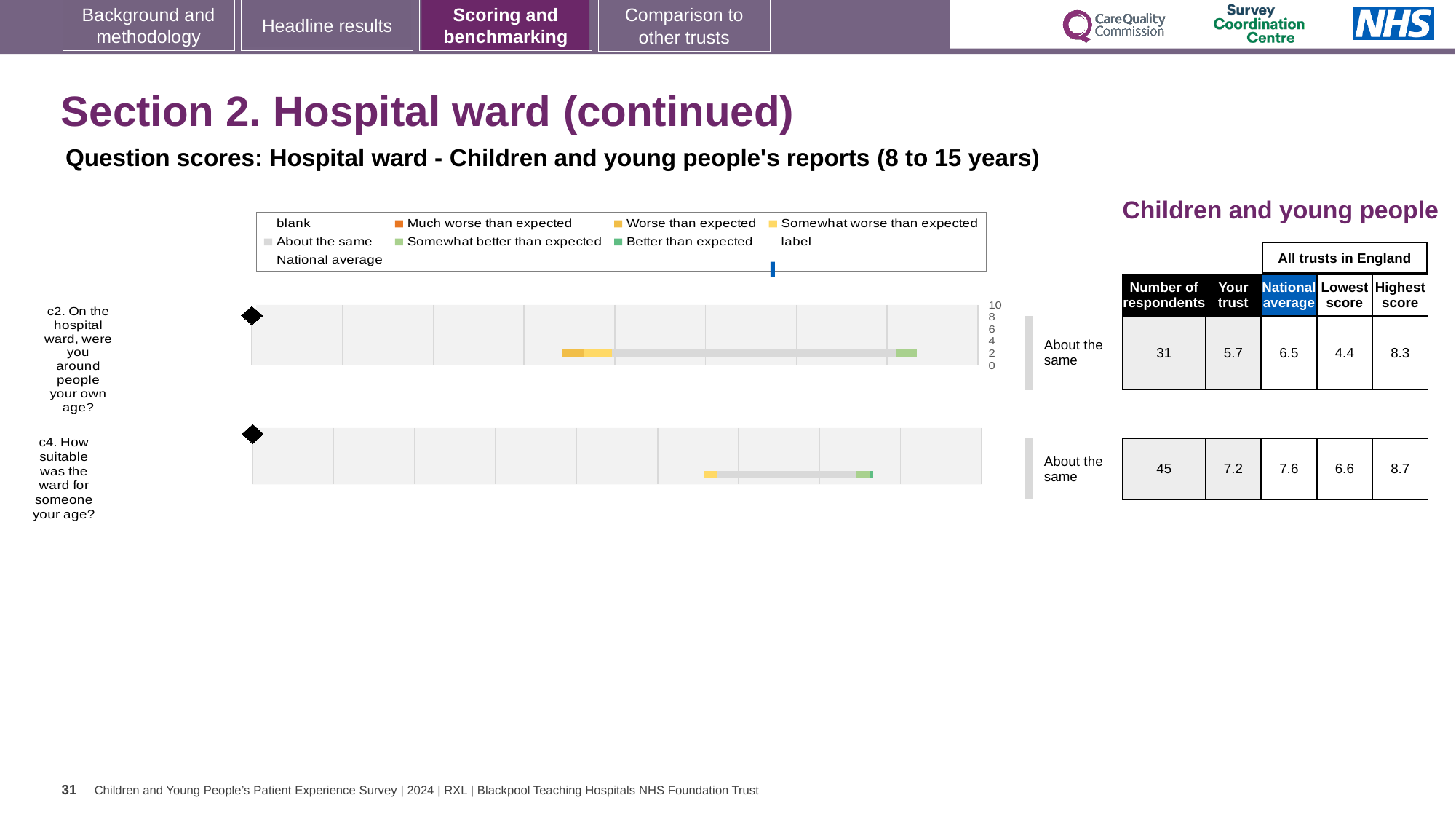
How many respondents answered question c2? 31 Which question has the higher 'Your trust' score, c2 or c4? c4 What is the lowest score among all trusts in England for question c2? 4.4 How many questions are plotted in the chart? 2 What is the title shown above the table of scores? Children and young people What is the national average score for question c4 (How suitable was the ward for someone your age?)? 7.6 What kind of chart is used to show the question scores on this slide? bar chart What benchmark category is shown for question c2? About the same What is the 'Your trust' score for question c2 (On the hospital ward, were you around people your own age?)? 5.7 By how much is the national average higher than the 'Your trust' score for question c2? 0.8 What is the difference between the highest and lowest scores for question c4? 2.1 What is the highest score among all trusts in England for question c4? 8.7